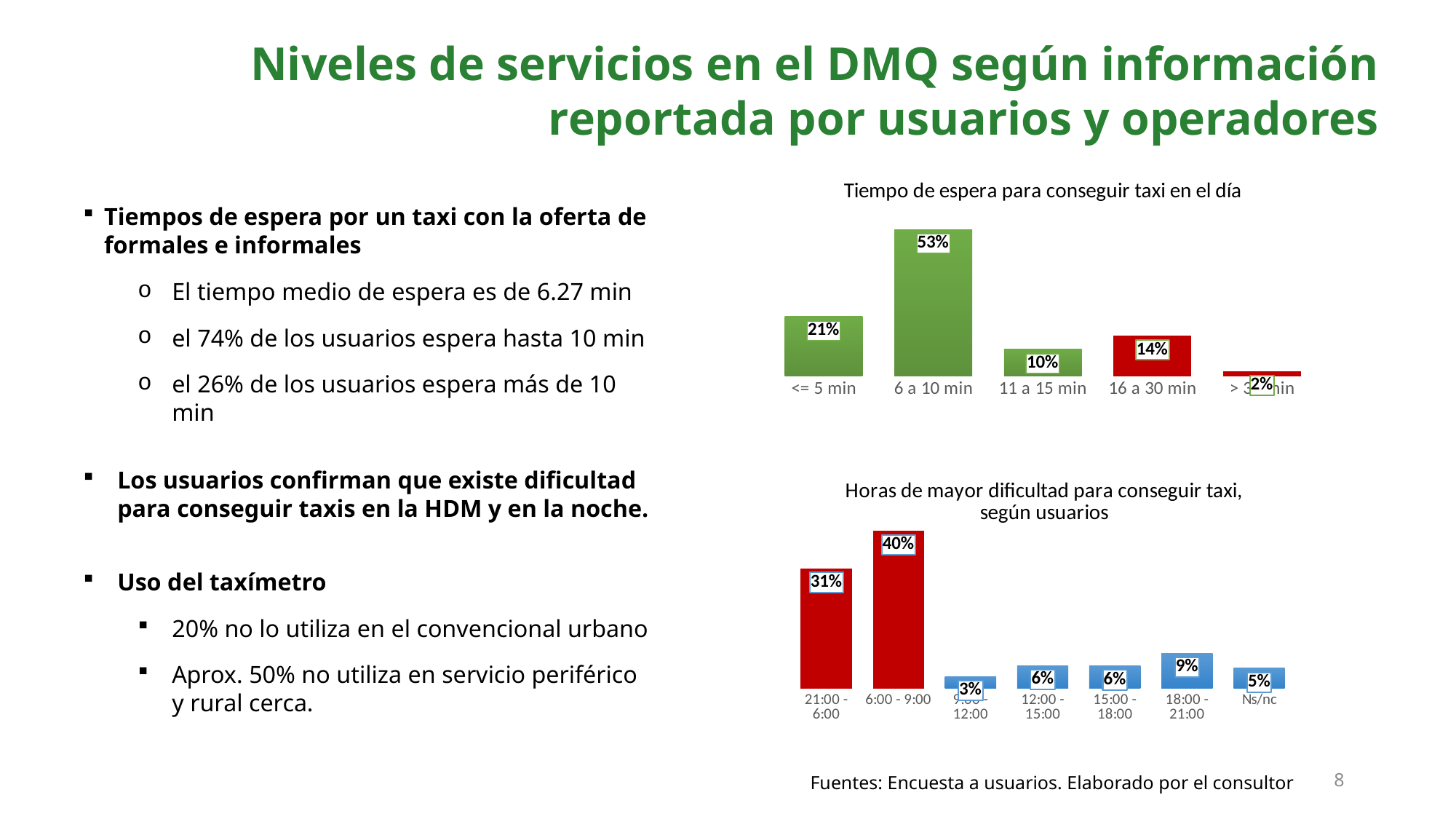
In the chart 'Horas de mayor dificultad para conseguir taxi, según usuarios', what is the value for '6:00 - 9:00'? 40% In the chart 'Tiempo de espera para conseguir taxi en el día', what is the value for '<= 5 min'? 21% In the chart 'Horas de mayor dificultad para conseguir taxi, según usuarios', what is the difference between the values for '6:00 - 9:00' and '21:00 - 6:00'? 9% In the chart 'Horas de mayor dificultad para conseguir taxi, según usuarios', which category has the lowest value? 9:00 - 12:00 In the chart 'Tiempo de espera para conseguir taxi en el día', what is the value for '6 a 10 min'? 53% What kind of chart is 'Tiempo de espera para conseguir taxi en el día'? bar chart In the chart 'Tiempo de espera para conseguir taxi en el día', which category has the highest value? 6 a 10 min In the chart 'Horas de mayor dificultad para conseguir taxi, según usuarios', what is the value for '18:00 - 21:00'? 9% In the chart 'Horas de mayor dificultad para conseguir taxi, según usuarios', which is larger: the value for '21:00 - 6:00' or the value for '6:00 - 9:00'? 6:00 - 9:00 In the chart 'Tiempo de espera para conseguir taxi en el día', what is the difference between the values for '16 a 30 min' and '11 a 15 min'? 4% In the chart 'Tiempo de espera para conseguir taxi en el día', how many categories are shown? 5 In the chart 'Horas de mayor dificultad para conseguir taxi, según usuarios', how many categories are shown? 7